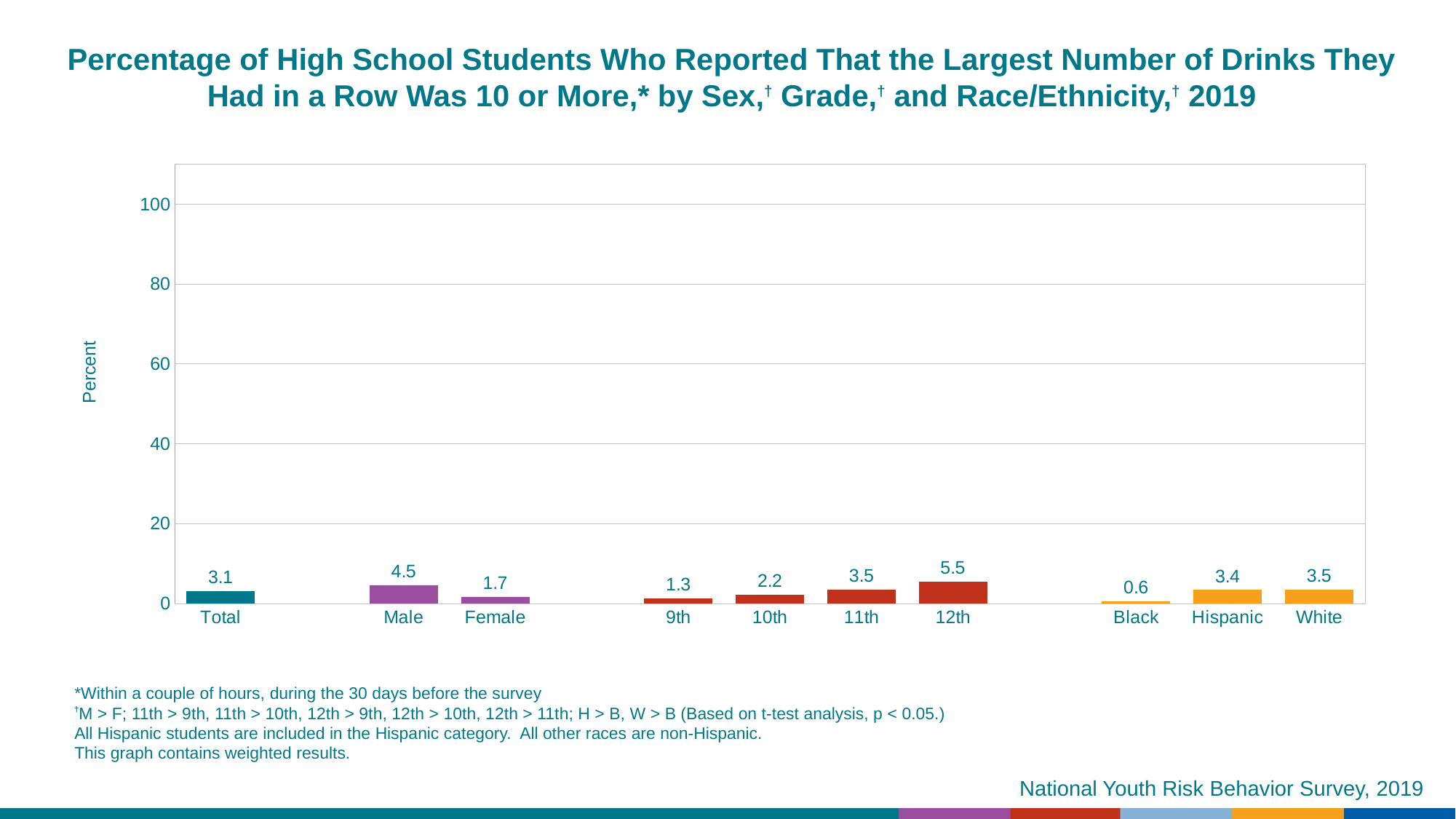
What is the value for Male? 4.5 Which category has the highest value? 12th Do the values rise or fall from 9th grade to 12th grade? rise What is the value for 12th grade? 5.5 What is the difference between the values for 12th and 9th grade? 4.2 Which category has the lowest value? Black What kind of chart is this? bar chart What is the difference between the values for Male and Female? 2.8 What is the value for Total? 3.1 How many categories are shown on the x axis? 10 Which is larger, the value for Hispanic or the value for Black? Hispanic What is the value for Black students? 0.6